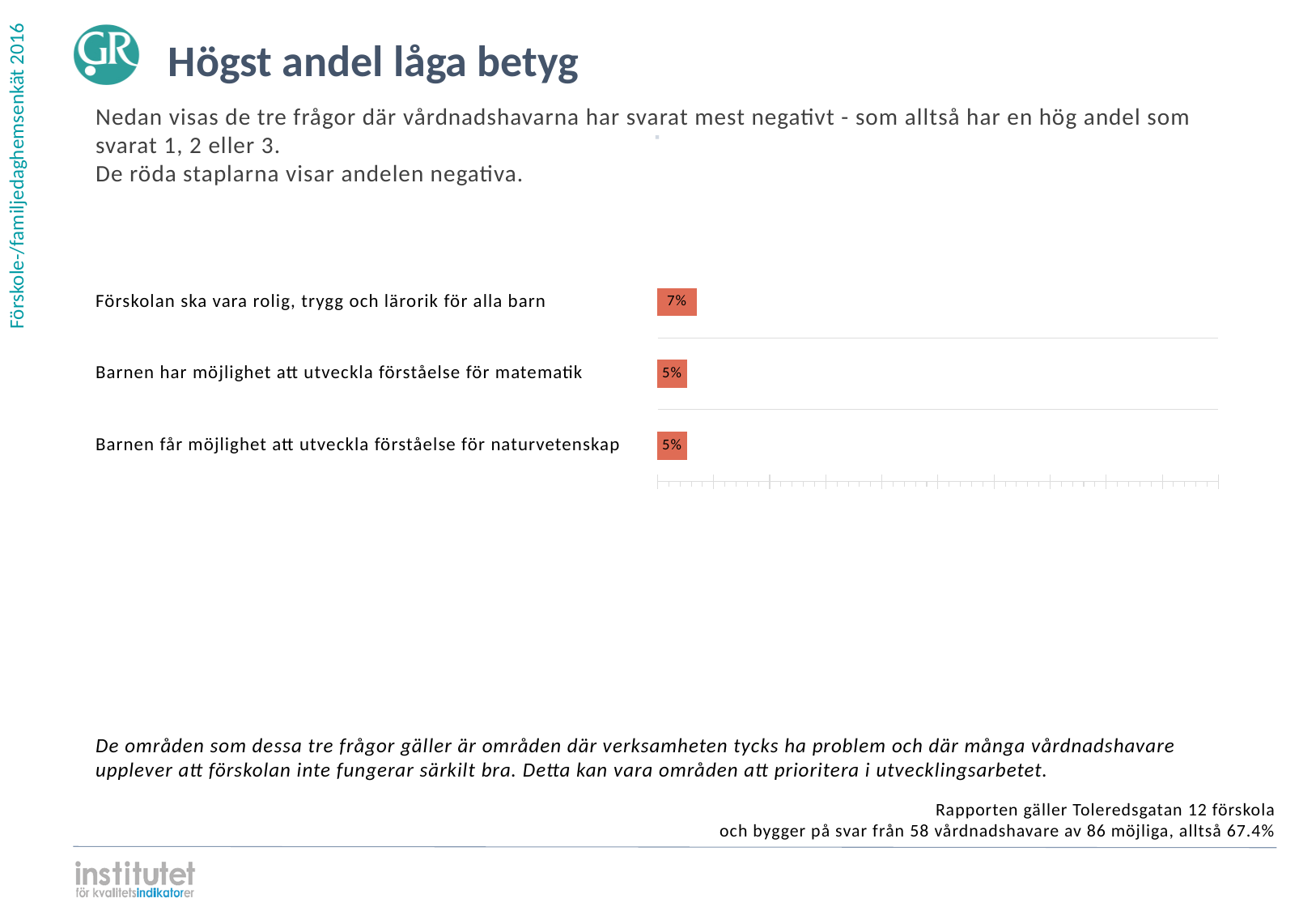
Do the values rise or fall going from the top bar to the bottom bar? Fall What is the value shown for "Barnen har möjlighet att utveckla förståelse för matematik"? 5% Which is larger: the value for "Förskolan ska vara rolig, trygg och lärorik för alla barn" or the value for "Barnen får möjlighet att utveckla förståelse för naturvetenskap"? Förskolan ska vara rolig, trygg och lärorik för alla barn What is the value shown for "Förskolan ska vara rolig, trygg och lärorik för alla barn"? 7% What is the difference between the value for "Förskolan ska vara rolig, trygg och lärorik för alla barn" and the value for "Barnen har möjlighet att utveckla förståelse för matematik"? 2 percentage points Which category has the highest value in the chart? Förskolan ska vara rolig, trygg och lärorik för alla barn What colour are the bars in the chart? Red What is the value shown for "Barnen får möjlighet att utveckla förståelse för naturvetenskap"? 5% How many categories are shown in the chart? 3 What kind of chart is shown on the slide? Bar chart What is the title of the slide containing the chart? Högst andel låga betyg